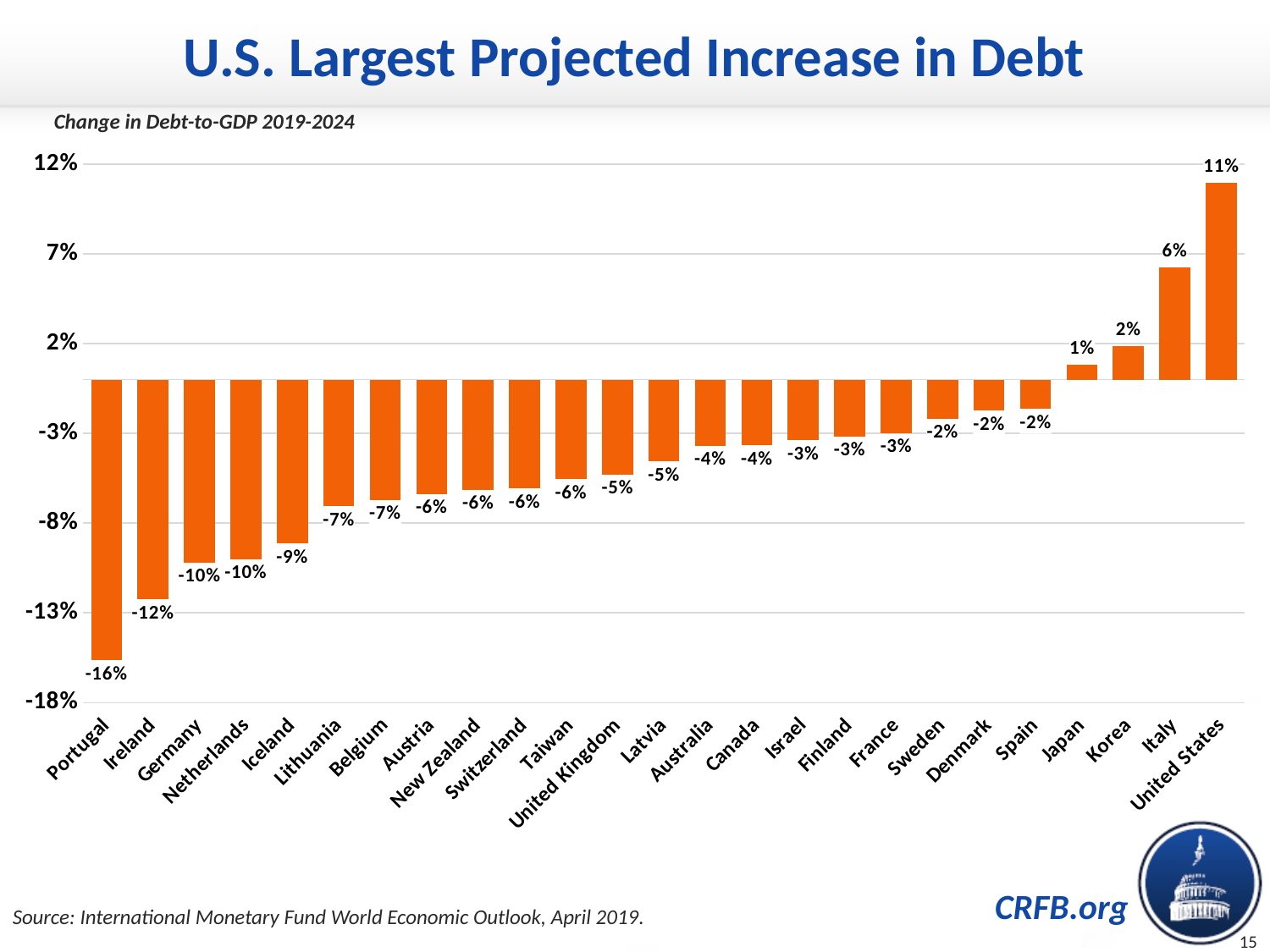
Which country has the highest projected change in debt-to-GDP? United States What kind of chart is shown on the slide? Bar chart What is the value shown for Japan? 1% Which country has the lowest projected change in debt-to-GDP? Portugal Which has a larger value, Iceland or Germany? Iceland Which has a larger value, Korea or Italy? Italy What is the value shown for Ireland? -12% How many countries are shown on the chart? 25 What is the change in debt-to-GDP shown for the United States? 11% What is the value shown for Portugal? -16% What is the subtitle of the chart? Change in Debt-to-GDP 2019-2024 How many percentage points higher is the United States value than the Italy value? 5 percentage points